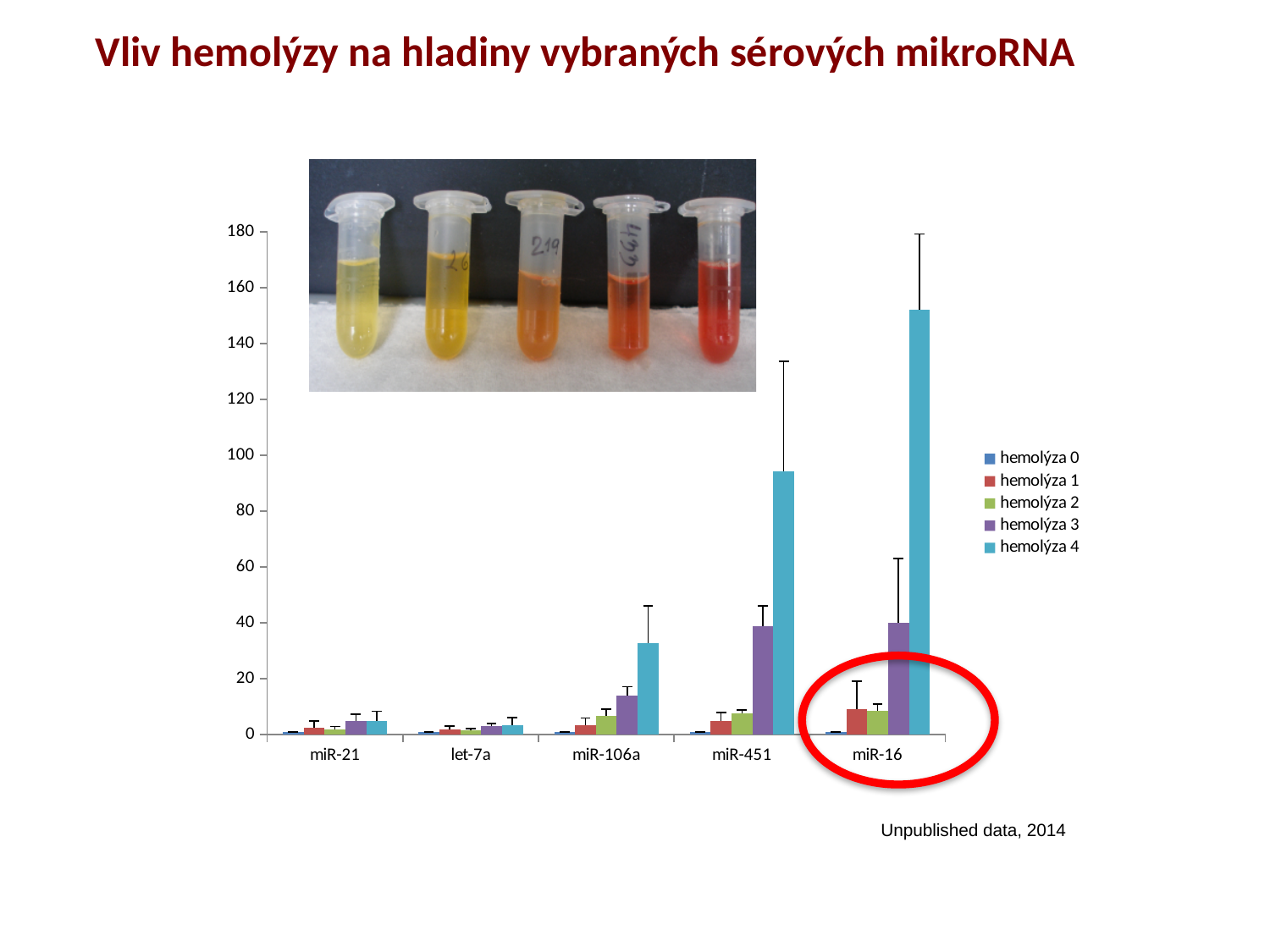
Is the hemolýza 4 value for miR-106a greater or less than 20? greater Which has the larger hemolýza 4 value: miR-451 or miR-16? miR-16 Is the hemolýza 4 value for miR-451 greater or less than 80? greater How many series does the legend list? 5 For miR-451, do the values rise or fall from hemolýza 0 to hemolýza 4? rise Which is larger for miR-451: the hemolýza 3 bar or the hemolýza 4 bar? hemolýza 4 What kind of chart is shown on the slide? bar chart Which category on the x axis is circled in red? miR-16 Which category has the highest hemolýza 4 bar? miR-16 Is the hemolýza 3 value for miR-16 greater or less than 60? less How many microRNA categories are shown on the x axis? 5